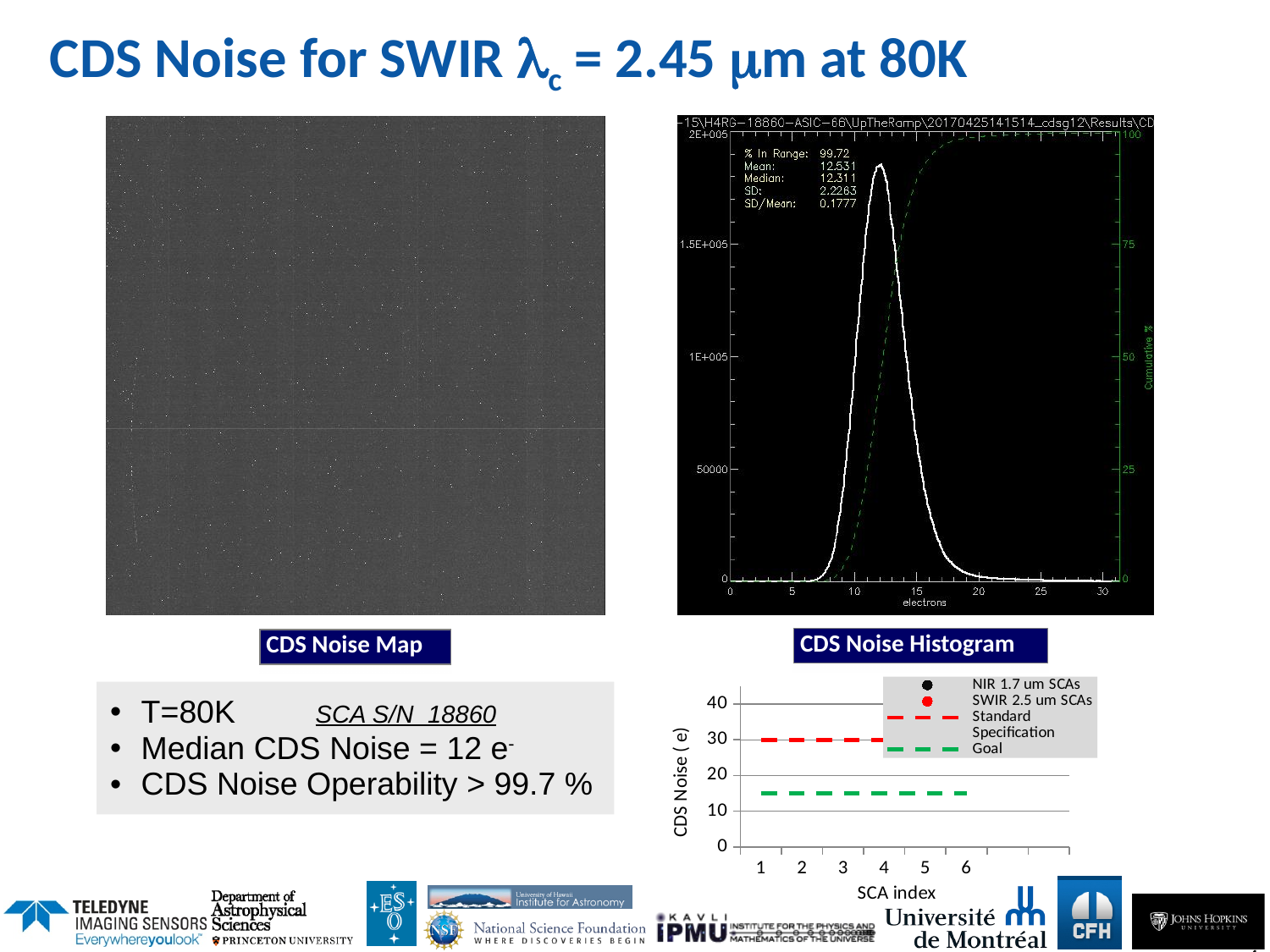
In the CDS Noise Histogram, what is the printed SD/Mean value? 0.1777 In the CDS Noise Histogram, what Mean value is printed in the statistics box? 12.531 In the bottom-right CDS Noise vs SCA index chart, is the Goal dashed line greater or less than 20? less In the CDS Noise Histogram, what Median value is printed in the statistics box? 12.311 In the CDS Noise Histogram, does the green dashed cumulative line rise or fall along the x axis? rise In the bottom-right CDS Noise vs SCA index chart, how many entries does the legend list? 4 In the CDS Noise Histogram, is the peak of the white curve greater or less than 1.5E+005? greater In the bottom-right CDS Noise vs SCA index chart, which line is higher, Standard Specification or Goal? Standard Specification In the CDS Noise Histogram, what SD value is printed? 2.2263 In the CDS Noise Histogram, what is the printed '% In Range' value? 99.72 In the CDS Noise Histogram, what is the label of the x axis? electrons In the bottom-right CDS Noise vs SCA index chart, at what CDS Noise value is the Standard Specification dashed line drawn? 30